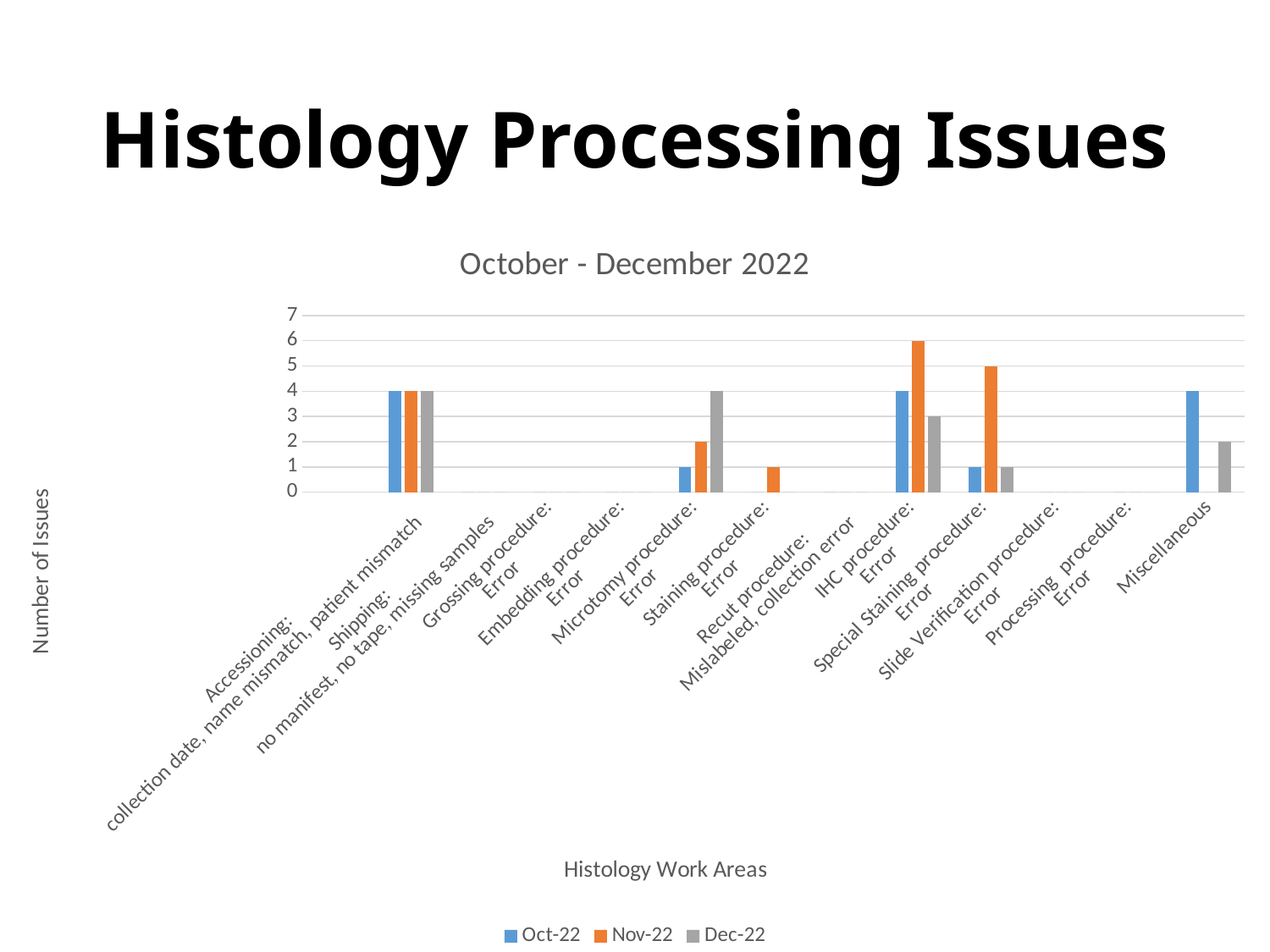
Is the Nov-22 value for Special Staining procedure: Error greater or less than 3? greater What is the Dec-22 value for Microtomy procedure: Error? 4 How many series does the legend list? 3 How many work-area categories are shown on the x axis? 12 What is the Nov-22 value for IHC procedure: Error? 6 What kind of chart is shown on the slide? bar chart What is the Oct-22 value for Miscellaneous? 4 Which is larger for Special Staining procedure: Error, the Nov-22 value or the Oct-22 value? Nov-22 What is the title of the chart? October - December 2022 Which work area has the highest Nov-22 value? IHC procedure: Error What is the difference between the Nov-22 and Dec-22 values for IHC procedure: Error? 3 What is the total of the Oct-22, Nov-22 and Dec-22 values for Accessioning? 12